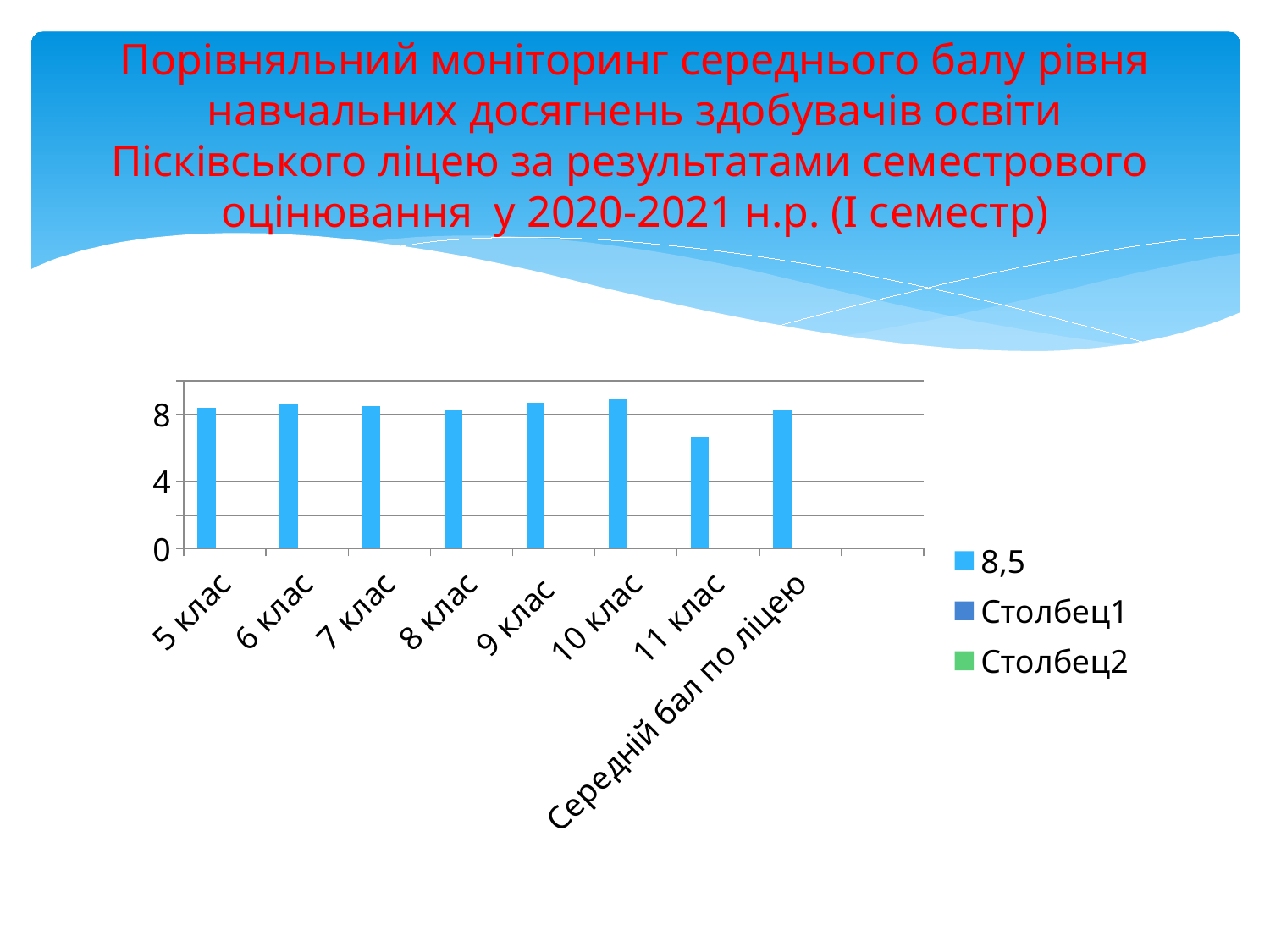
Is the value for 11 клас greater or less than 4? greater What is the first entry listed in the chart's legend? 8,5 What kind of chart is shown on the slide? bar chart What is the label of the last category on the x axis? Середній бал по ліцею Is the value for 10 клас greater or less than 8? greater How many entries does the chart's legend list? 3 Which is larger, the value for 6 клас or the value for 11 клас? 6 клас Is the value for 11 клас greater or less than 8? less Which is larger, the value for 10 клас or the value for 11 клас? 10 клас How many categories are shown on the x axis of the chart? 8 Which category has the lowest bar in the chart? 11 клас